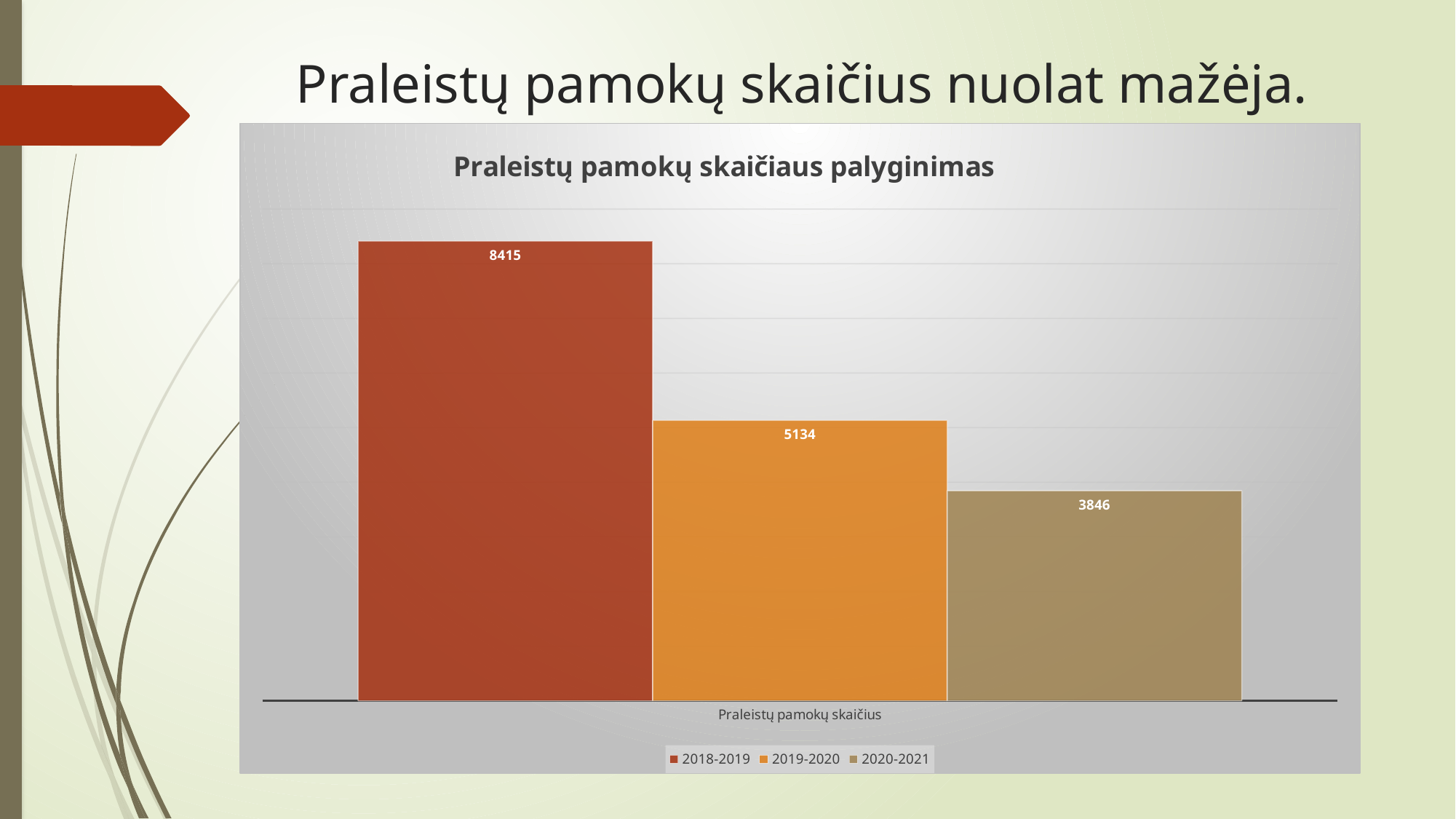
What is the value for 2020-2021? 3846 Which series has the highest value? 2018-2019 Do the values rise or fall from 2018-2019 to 2020-2021? fall How many series does the legend list? 3 Which series has the lowest value? 2020-2021 What kind of chart is shown on the slide? bar chart What is the value for 2019-2020? 5134 What is the difference between the 2019-2020 and 2020-2021 values? 1288 Which is larger, the value for 2019-2020 or the value for 2020-2021? 2019-2020 What is the difference between the 2018-2019 and 2019-2020 values? 3281 What is the value for 2018-2019? 8415 What is the title of the chart? Praleistų pamokų skaičiaus palyginimas